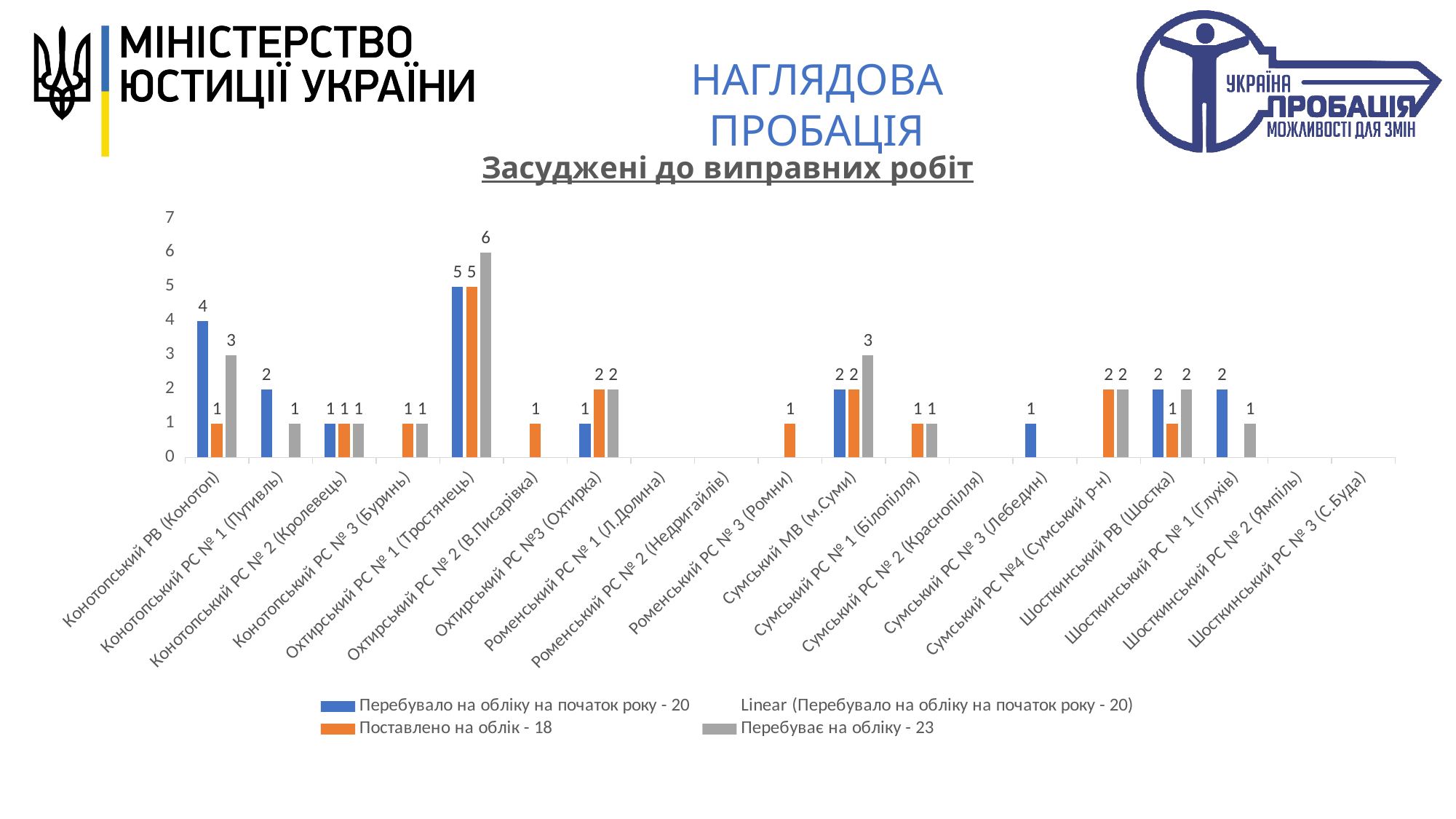
What is the difference between the 'Перебувало на обліку на початок року - 20' value and the 'Перебуває на обліку - 23' value for Конотопський РВ (Конотоп)? 1 What is the title of the chart? Засуджені до виправних робіт Which category has the highest value of 'Перебуває на обліку - 23'? Охтирський РС № 1 (Тростянець) What is the value of 'Перебуває на обліку - 23' for Охтирський РС № 1 (Тростянець)? 6 What is the value of 'Поставлено на облік - 18' for Охтирський РС №3 (Охтирка)? 2 What type of chart is shown on the slide? bar chart What is the value of 'Перебуває на обліку - 23' for Сумський МВ (м.Суми)? 3 Which is larger for Шосткинський РС № 1 (Глухів): 'Перебувало на обліку на початок року - 20' or 'Перебуває на обліку - 23'? Перебувало на обліку на початок року - 20 How many categories are shown on the x axis? 19 How many entries does the legend list? 4 What is the value of 'Перебувало на обліку на початок року - 20' for Конотопський РВ (Конотоп)? 4 What colour are the bars for 'Поставлено на облік - 18'? orange